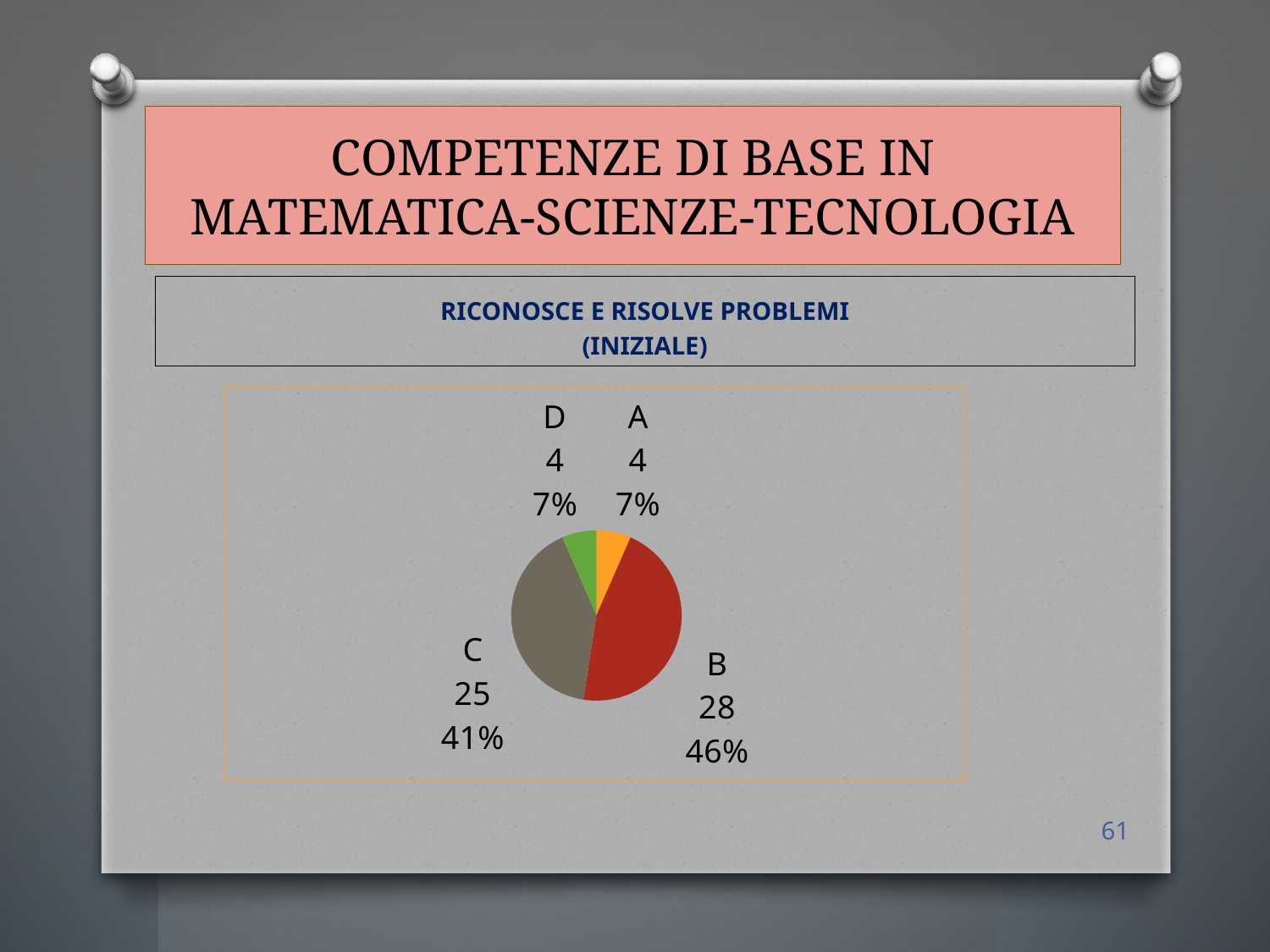
How many slices does the pie chart have? 4 What percentage is shown for slice A? 7% What percentage is shown for slice C? 41% What colour is the slice for B? red What is the difference between the counts for B and C? 3 What is the count shown for slice D? 4 What is the total of the counts shown for all four slices? 61 Which slice has the largest share of the pie? B What is the title shown above the chart? RICONOSCE E RISOLVE PROBLEMI (INIZIALE) What kind of chart is shown on the slide? pie chart Which is larger, the count for C or the count for A? C What is the count shown for slice B? 28